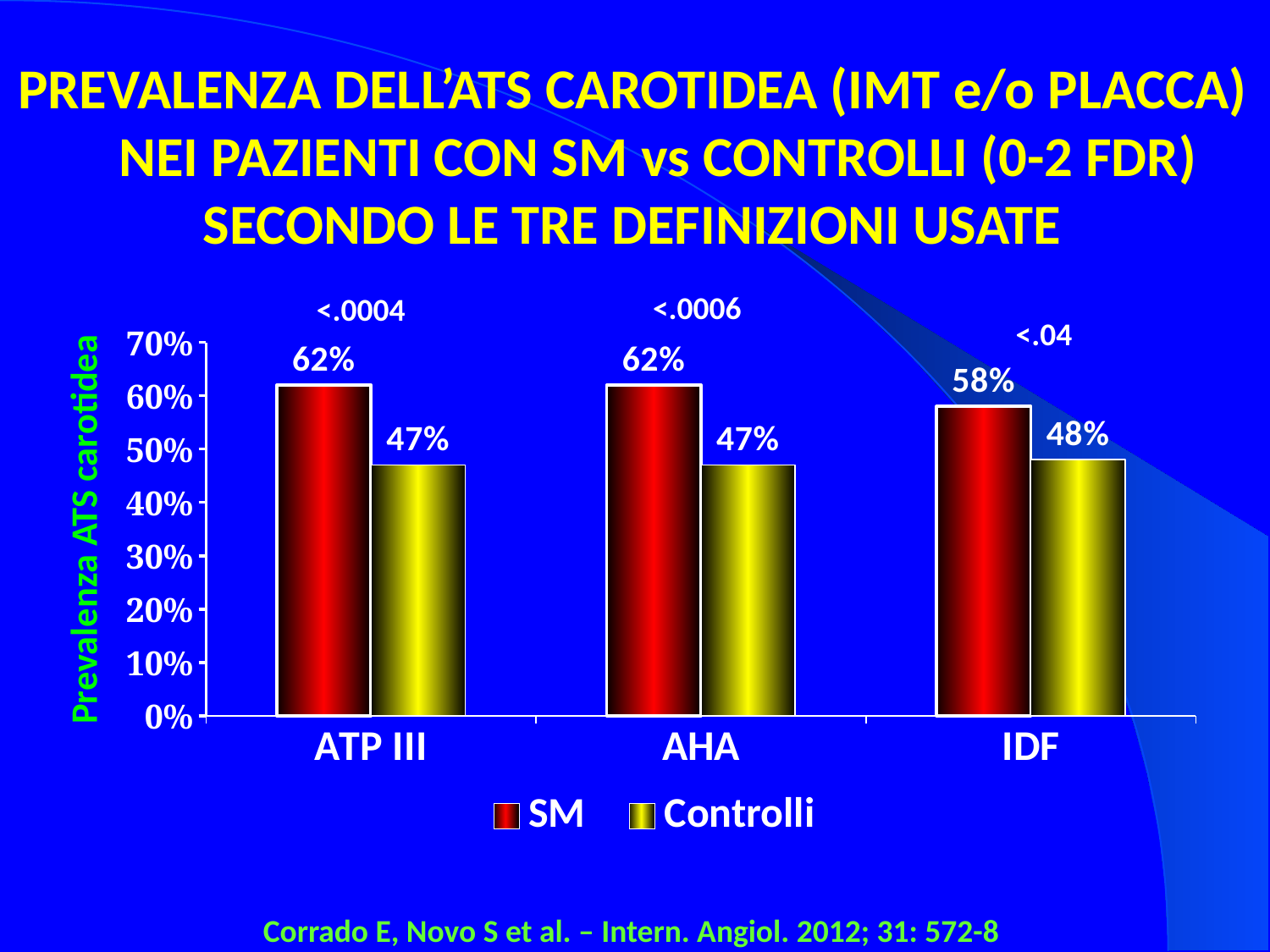
What is the value for Controlli in the AHA category? 47% What is the value for Controlli in the IDF category? 48% What is the difference between the SM and Controlli values in the IDF category? 10% Which category has the highest value for the Controlli series? IDF What is the value for SM in the ATP III category? 62% Which category has the lowest value for the SM series? IDF What is the value for SM in the IDF category? 58% How many series does the legend list? 2 In the AHA category, which series has the larger value, SM or Controlli? SM What is the difference between the SM and Controlli values in the ATP III category? 15% How many categories are shown on the x axis? 3 What kind of chart is shown on the slide? Bar chart